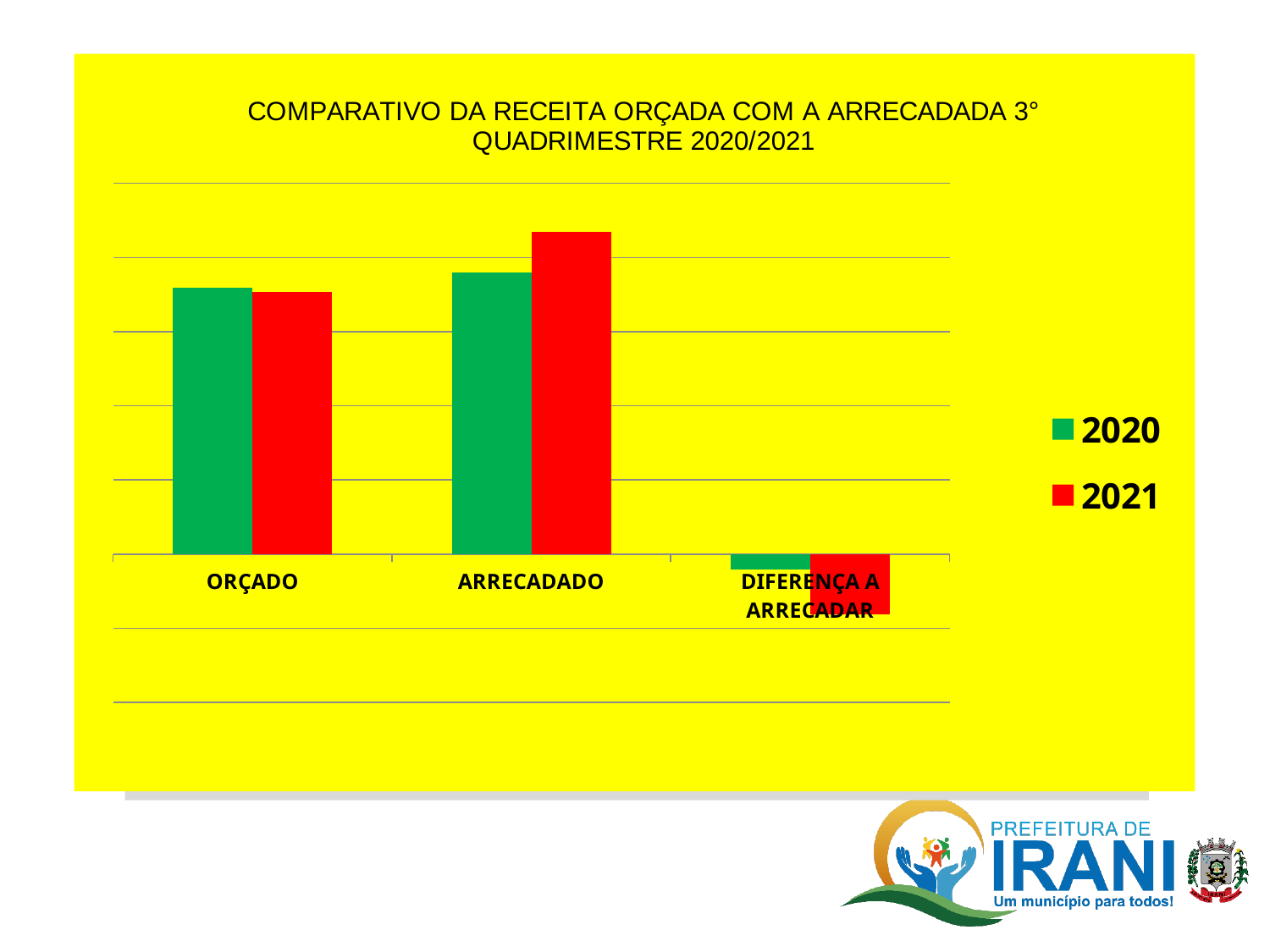
For ARRECADADO, which series has the larger value, 2020 or 2021? 2021 What kind of chart is shown on the slide? bar chart Which category has the lowest value for the 2021 series? DIFERENÇA A ARRECADAR How many categories are shown on the x axis? 3 Which category has the highest value for the 2020 series? ARRECADADO Which colour represents the 2020 series in the legend? green For the 2021 series, which is larger, ORÇADO or ARRECADADO? ARRECADADO How many series does the legend list? 2 What is the title of the chart? COMPARATIVO DA RECEITA ORÇADA COM A ARRECADADA 3° QUADRIMESTRE 2020/2021 Which category has the highest value for the 2021 series? ARRECADADO Which category has the lowest value for the 2020 series? DIFERENÇA A ARRECADAR For DIFERENÇA A ARRECADAR, which series has the lower (more negative) value, 2020 or 2021? 2021